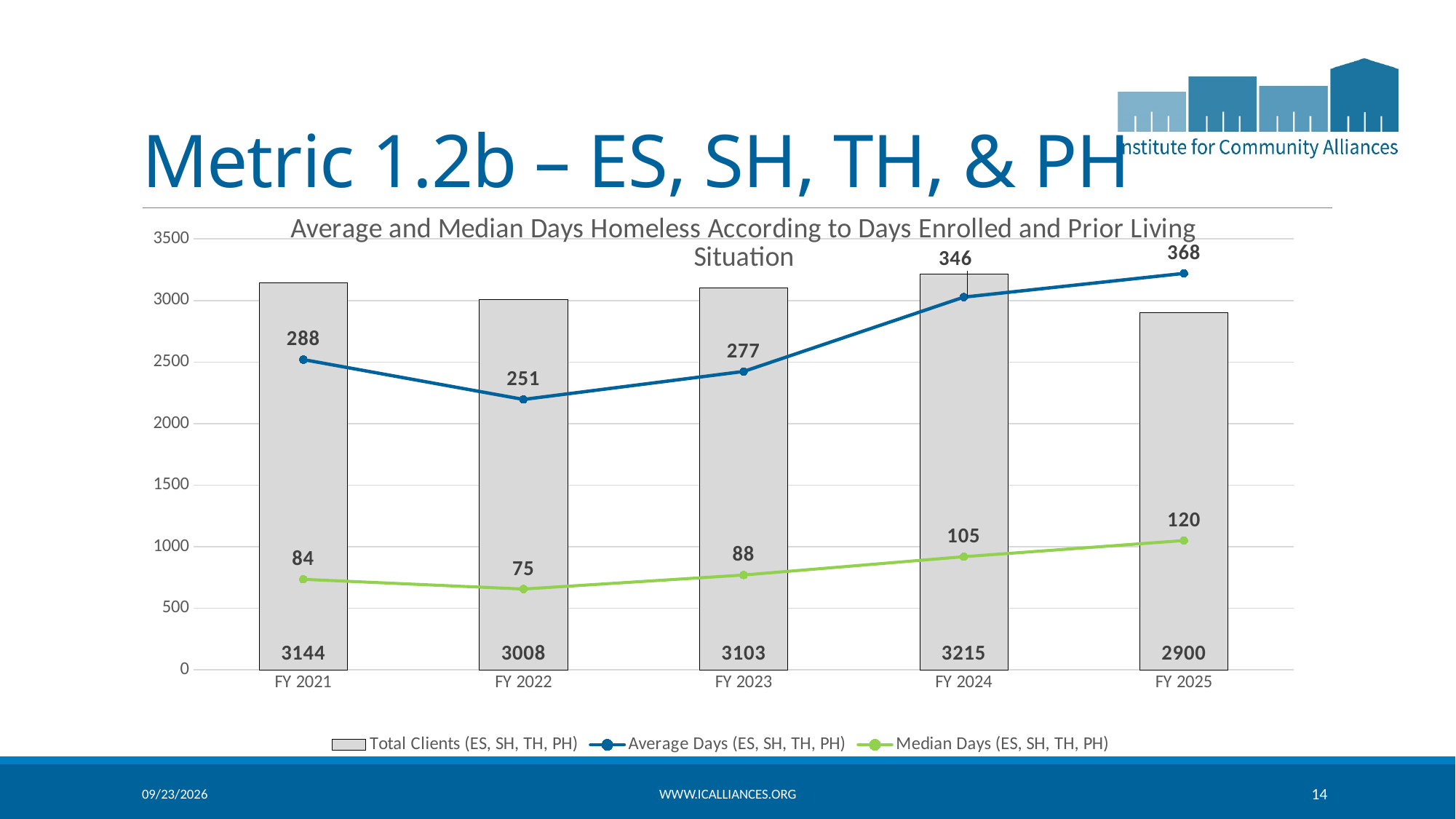
How many fiscal years are shown on the x axis? 5 How many series does the legend list? 3 Which fiscal year has the highest Total Clients (ES, SH, TH, PH)? FY 2024 Which is larger, the Average Days value for FY 2021 or for FY 2023? FY 2021 Does the Average Days (ES, SH, TH, PH) series rise or fall from FY 2022 to FY 2025? rise Is the Total Clients bar for FY 2025 greater or less than 3000? less What is the difference in Total Clients (ES, SH, TH, PH) between FY 2021 and FY 2025? 244 Which fiscal year has the lowest Median Days (ES, SH, TH, PH)? FY 2022 What is the Average Days (ES, SH, TH, PH) value for FY 2022? 251 What is the Median Days (ES, SH, TH, PH) value for FY 2025? 120 What is the value of Total Clients (ES, SH, TH, PH) for FY 2024? 3215 What is the difference between Average Days and Median Days (ES, SH, TH, PH) in FY 2024? 241